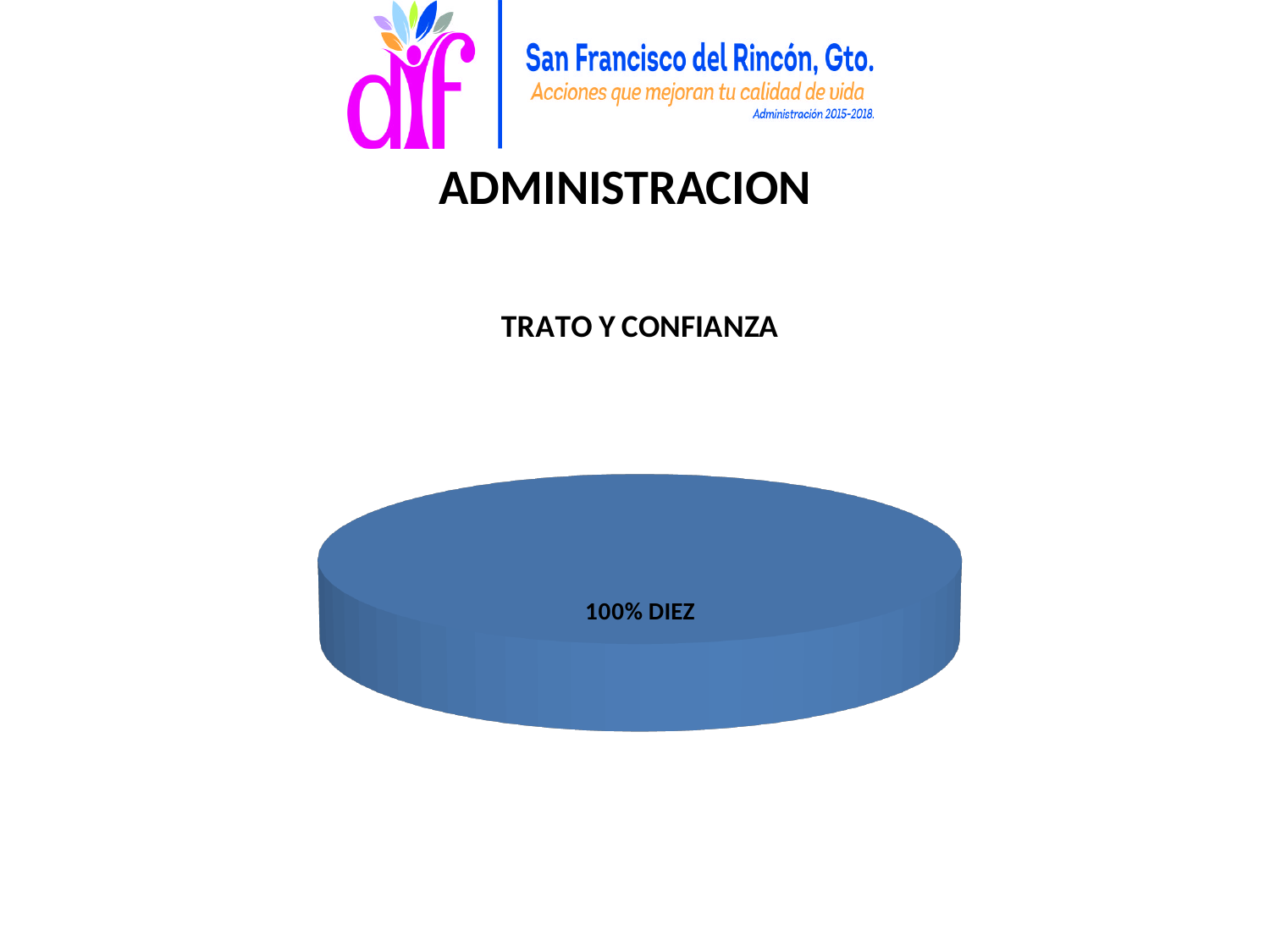
What is the title of the chart on the slide? TRATO Y CONFIANZA What share of the pie does the DIEZ slice represent? 100% What kind of chart is shown under the heading TRATO Y CONFIANZA? pie chart What colour is the pie chart slice? blue Which category makes up the entire pie chart? DIEZ How many slices does the pie chart contain? 1 What is the label printed on the single slice of the pie chart? 100% DIEZ